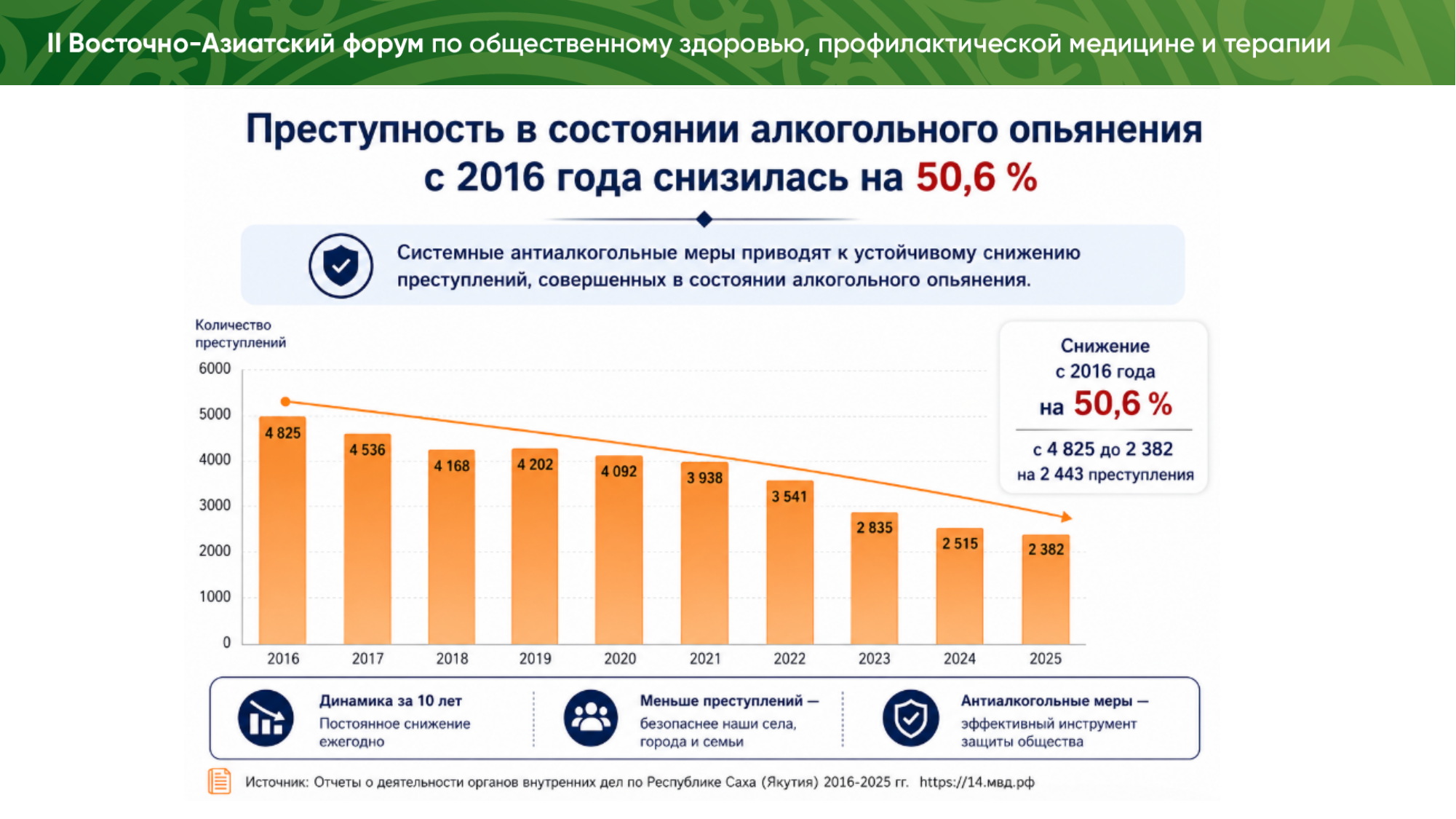
Which year has the highest number of crimes? 2016 What is the difference between the values for 2016 and 2025? 2 443 Which year has the larger value, 2018 or 2019? 2019 Do the values generally rise or fall from 2016 to 2025? fall Which year has the lowest number of crimes? 2025 What kind of chart is shown on the slide? bar chart What is the number of crimes shown for 2016? 4 825 How many years are shown on the x axis? 10 What is the difference between the values for 2022 and 2023? 706 Is the value for 2023 greater or less than 3000? less What is the number of crimes shown for 2025? 2 382 What value is shown for 2022? 3 541